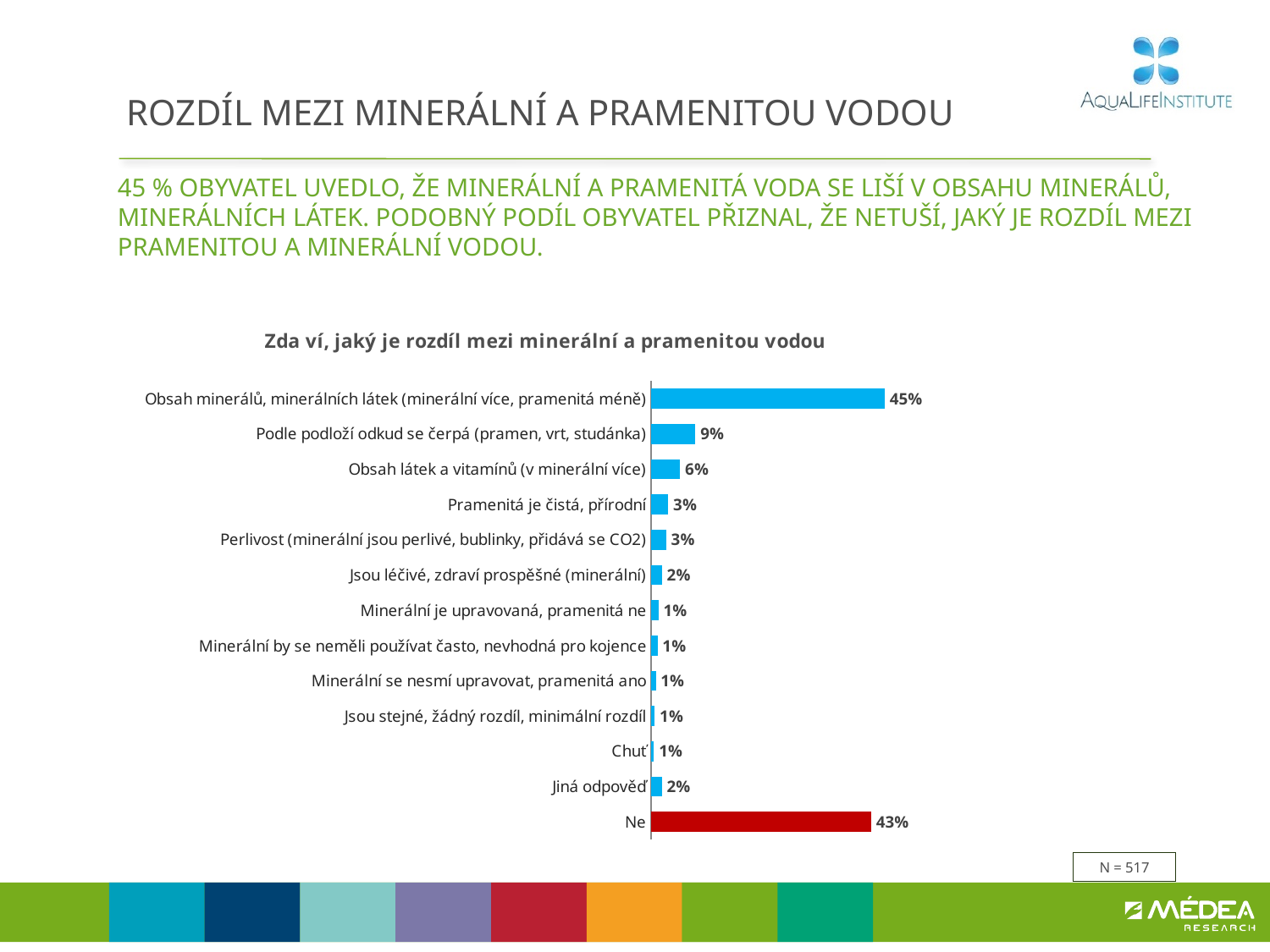
What is the value for "Ne"? 43% What is the value for "Obsah minerálů, minerálních látek (minerální více, pramenitá méně)"? 45% Which is larger: the value for "Podle podloží odkud se čerpá (pramen, vrt, studánka)" or for "Obsah látek a vitamínů (v minerální více)"? Podle podloží odkud se čerpá (pramen, vrt, studánka) Which category has the highest value? Obsah minerálů, minerálních látek (minerální více, pramenitá méně) What is the value for "Podle podloží odkud se čerpá (pramen, vrt, studánka)"? 9% What is the value for "Jiná odpověď"? 2% How many categories are shown in the chart? 13 What is the difference between the values for "Obsah minerálů, minerálních látek (minerální více, pramenitá méně)" and "Ne"? 2 percentage points What type of chart is shown on the slide? Bar chart What is the value for "Obsah látek a vitamínů (v minerální více)"? 6% What is the title of the chart? Zda ví, jaký je rozdíl mezi minerální a pramenitou vodou Which bar in the chart is coloured red rather than blue? Ne